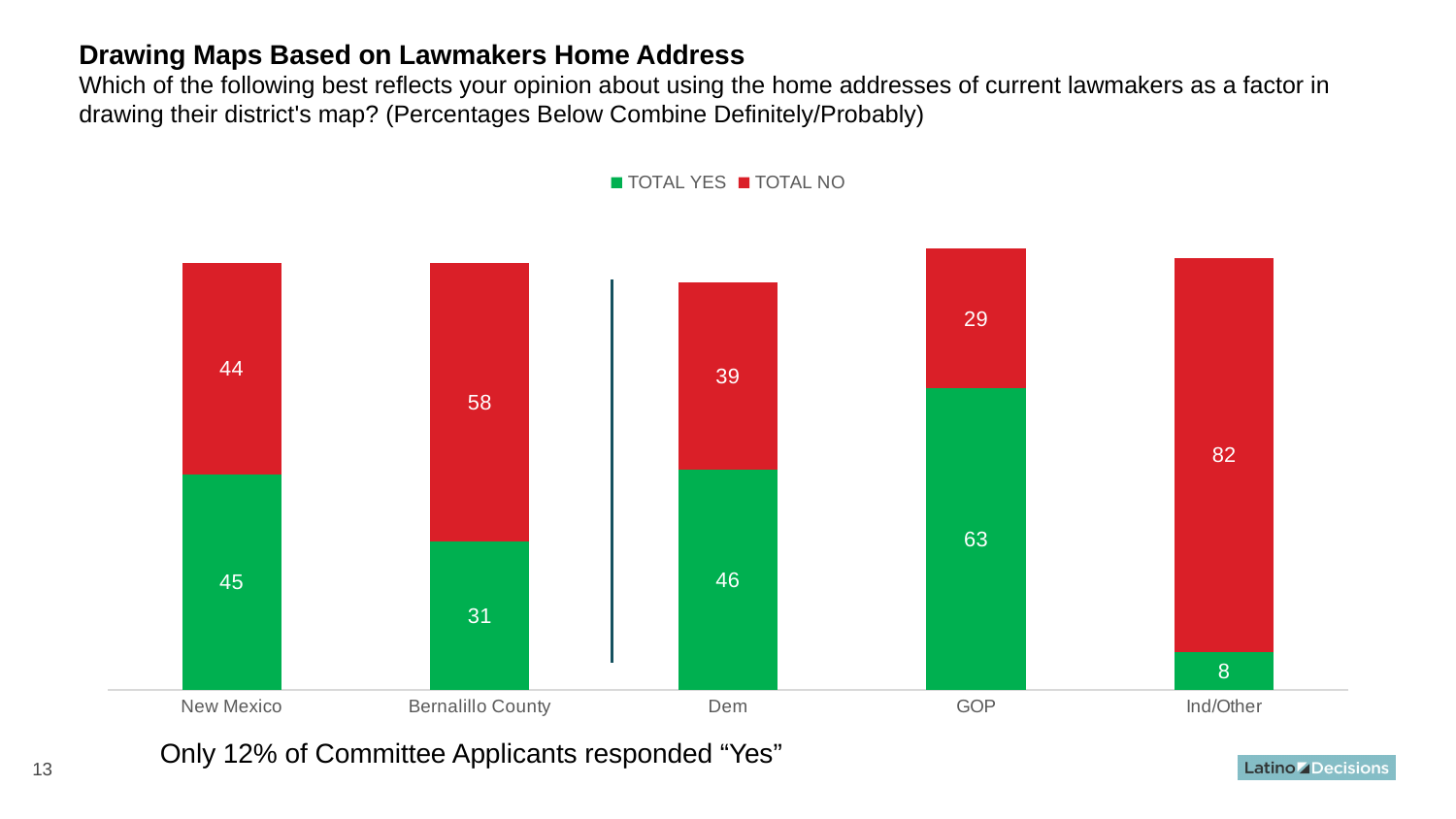
Which is larger for Dem, TOTAL YES or TOTAL NO? TOTAL YES What is the TOTAL YES value for GOP? 63 What is the TOTAL YES value for Ind/Other? 8 What kind of chart is shown on the slide? Stacked bar chart Which colour represents TOTAL NO in the legend? Red What is the total of the stacked bar for GOP? 92 Which category has the lowest TOTAL YES value? Ind/Other What is the TOTAL NO value for Bernalillo County? 58 What is the difference between the TOTAL NO and TOTAL YES values for Bernalillo County? 27 How many categories are shown on the x axis? 5 How many series does the legend list? 2 Which category has the highest TOTAL NO value? Ind/Other